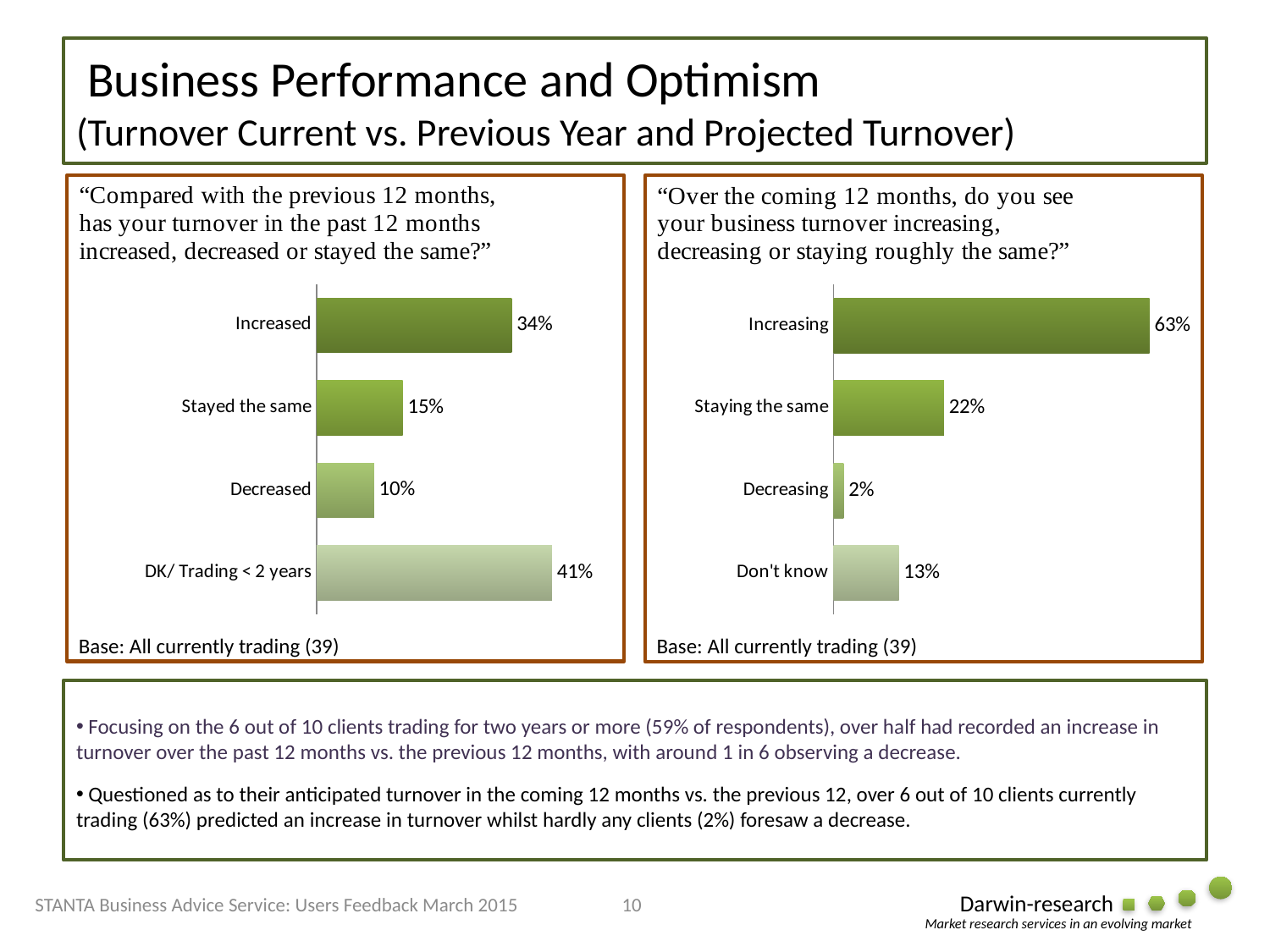
What type of chart is used in the right chart (projected turnover over the coming 12 months)? Bar chart In the left chart (turnover compared with the previous 12 months), what is the difference between 'Increased' and 'Decreased'? 24% How many categories are shown in the left chart (turnover compared with the previous 12 months)? 4 In the right chart (projected turnover over the coming 12 months), which category has the lowest value? Decreasing In the left chart (turnover compared with the previous 12 months), what percentage of respondents said their turnover increased? 34% In the right chart (projected turnover over the coming 12 months), what percentage said 'Increasing'? 63% Which is larger: 'Stayed the same' in the left chart or 'Staying the same' in the right chart? Staying the same in the right chart In the left chart (turnover compared with the previous 12 months), which category has the lowest value? Decreased In the right chart (projected turnover over the coming 12 months), what is the value for 'Don't know'? 13% In the right chart (projected turnover over the coming 12 months), what is the difference between 'Increasing' and 'Staying the same'? 41% In the right chart (projected turnover over the coming 12 months), which category has the highest value? Increasing In the left chart (turnover compared with the previous 12 months), what is the value for 'DK/ Trading < 2 years'? 41%